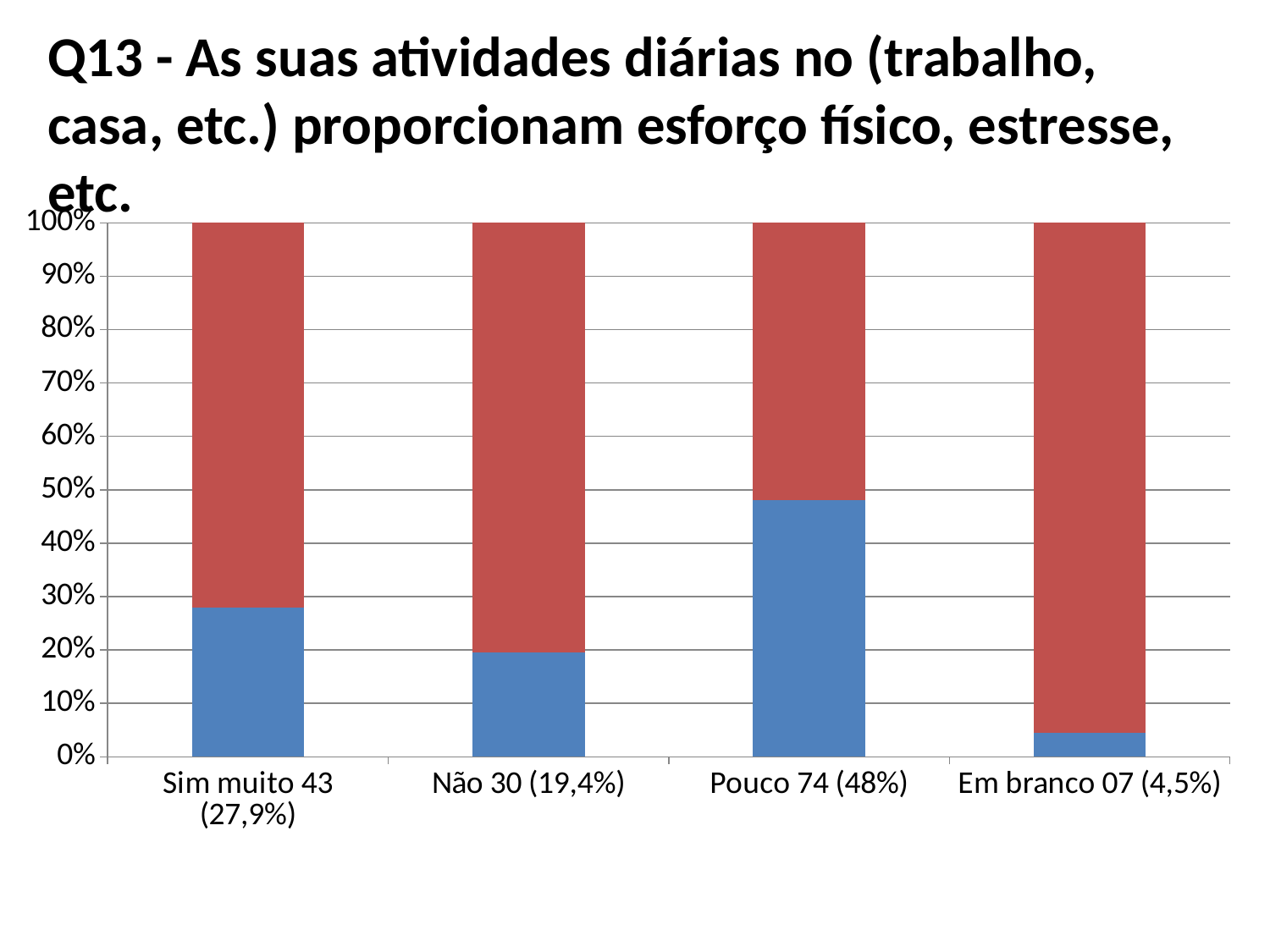
Which category has the shortest blue segment? Em branco 07 (4,5%) What percentage is printed in the category label for "Pouco"? 48% Is the blue segment for "Não" greater or less than 20%? less Which has a taller blue segment, "Sim muito" or "Não"? Sim muito What kind of chart is shown on the slide? Stacked bar chart What percentage is printed in the category label for "Em branco"? 4,5% Which category has the tallest blue segment? Pouco 74 (48%) How many categories are shown on the x axis of the chart? 4 What is the highest value shown on the y axis of the chart? 100% What percentage is printed in the category label for "Sim muito"? 27,9% What count is printed in the category label for "Não"? 30 Is the blue segment for "Pouco" greater or less than 40%? greater